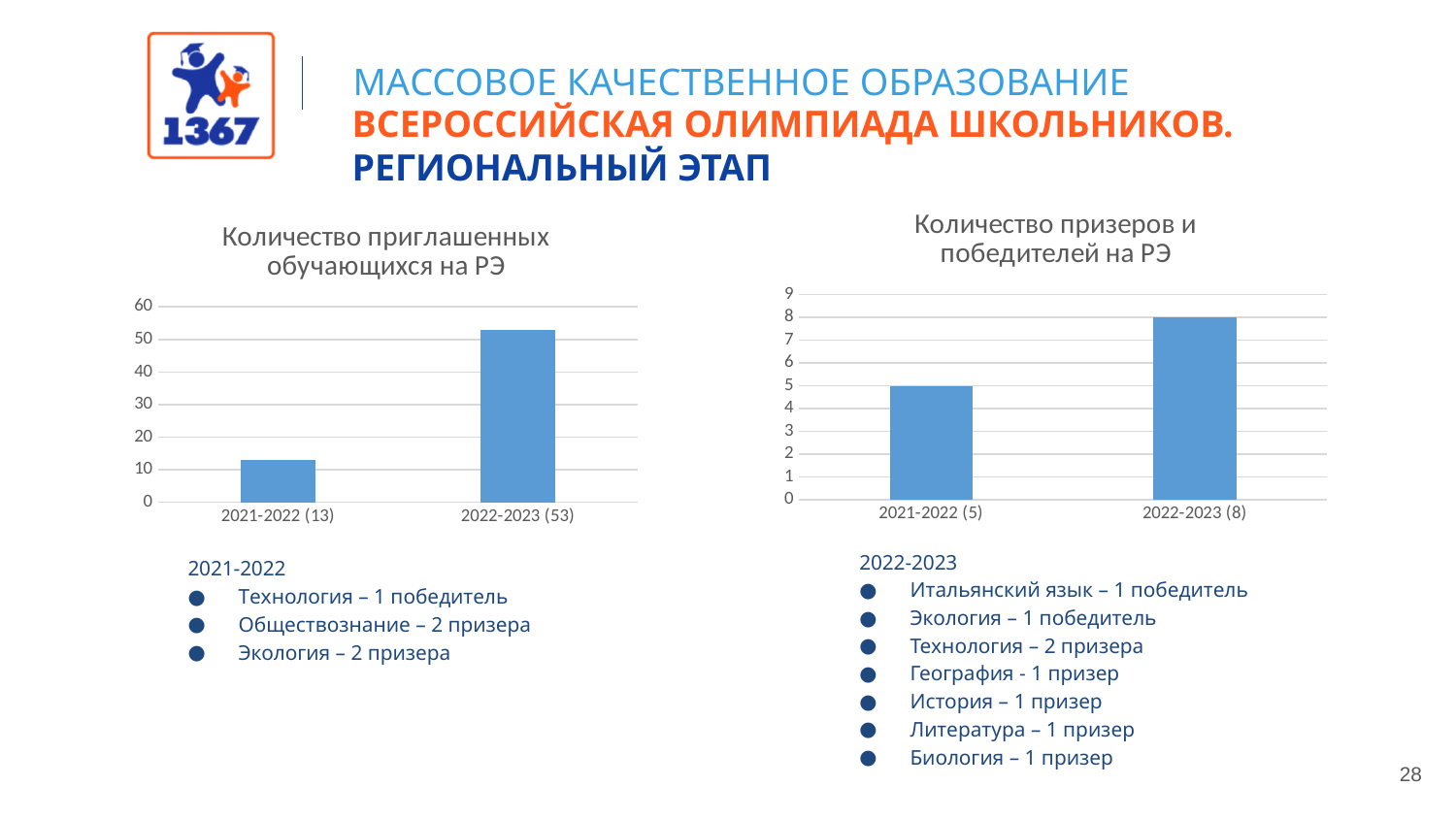
In the chart 'Количество приглашенных обучающихся на РЭ', what is the value for 2021-2022? 13 In the chart 'Количество призеров и победителей на РЭ', do the values rise or fall from 2021-2022 to 2022-2023? rise In the chart 'Количество призеров и победителей на РЭ', what is the value for 2021-2022? 5 In the chart 'Количество призеров и победителей на РЭ', what is the value for 2022-2023? 8 In the chart 'Количество приглашенных обучающихся на РЭ', which category has the highest value? 2022-2023 How many categories are shown in the chart 'Количество приглашенных обучающихся на РЭ'? 2 What kind of chart is the chart on the right of the slide? bar chart In the chart 'Количество приглашенных обучающихся на РЭ', what is the value for 2022-2023? 53 In the chart 'Количество приглашенных обучающихся на РЭ', is the value for 2022-2023 greater or less than 50? greater In the chart 'Количество призеров и победителей на РЭ', what is the difference between the 2022-2023 and 2021-2022 values? 3 In the chart 'Количество приглашенных обучающихся на РЭ', what is the difference between the 2022-2023 and 2021-2022 values? 40 In the chart 'Количество призеров и победителей на РЭ', which category has the lowest value? 2021-2022